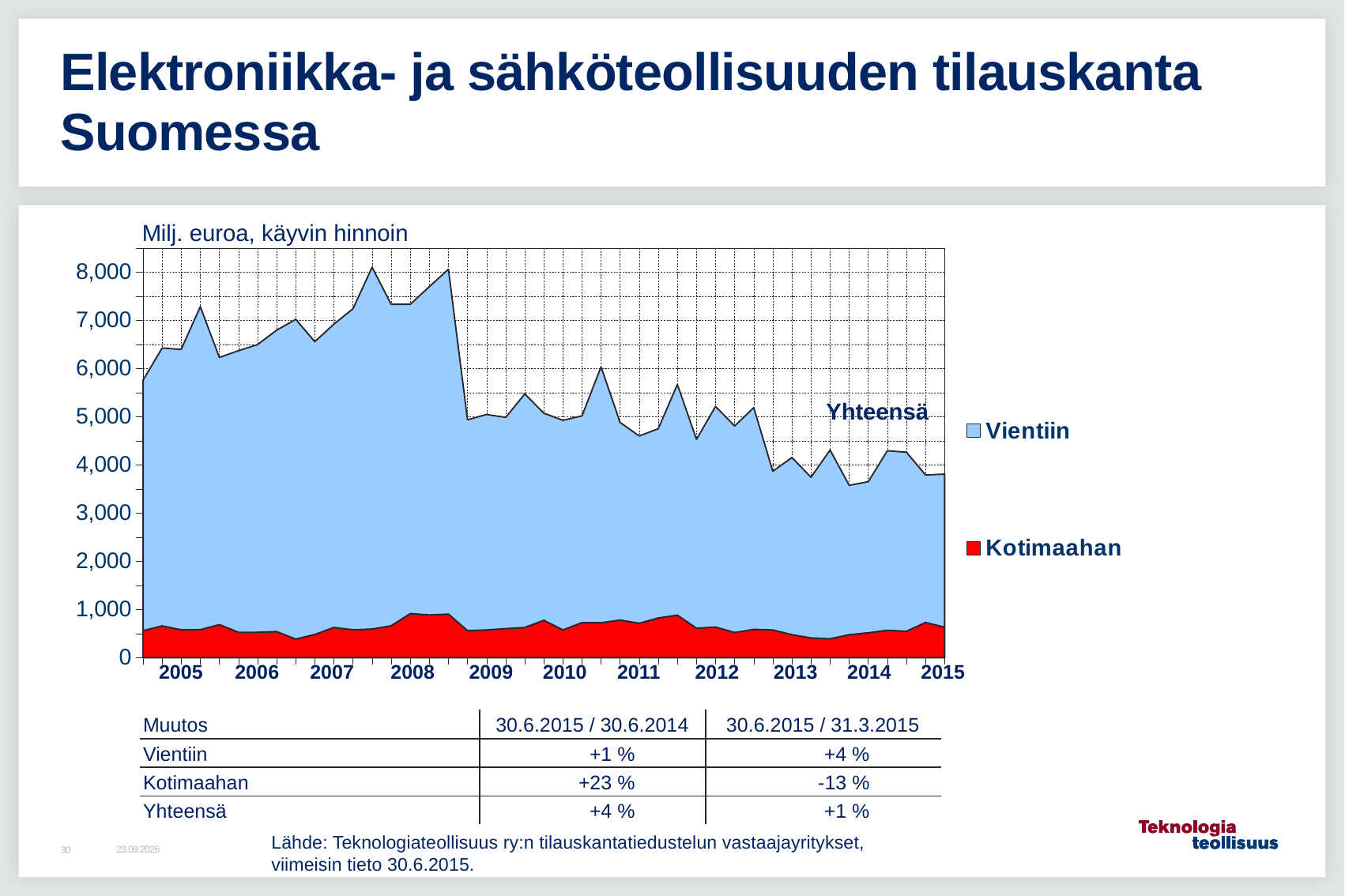
How many year labels are shown on the x axis? 11 Is the total (Yhteensä) value at the peak around 2008 greater or less than 7,000? greater According to the table below the chart, what is the change for Kotimaahan from 30.6.2014 to 30.6.2015? +23 % Is the total (Yhteensä) value at the end of the series in 2015 greater or less than 5,000? less How many series does the chart legend list? 2 Is the total (Yhteensä) value at the start of 2005 greater or less than 5,000? greater What kind of chart is shown on the slide? Area chart What unit label is shown above the chart? Milj. euroa, käyvin hinnoin Which series is larger throughout the chart, Vientiin or Kotimaahan? Vientiin Does the total order backlog (Yhteensä) rise or fall between 2008 and 2015? fall Which two series are listed in the chart legend? Vientiin and Kotimaahan